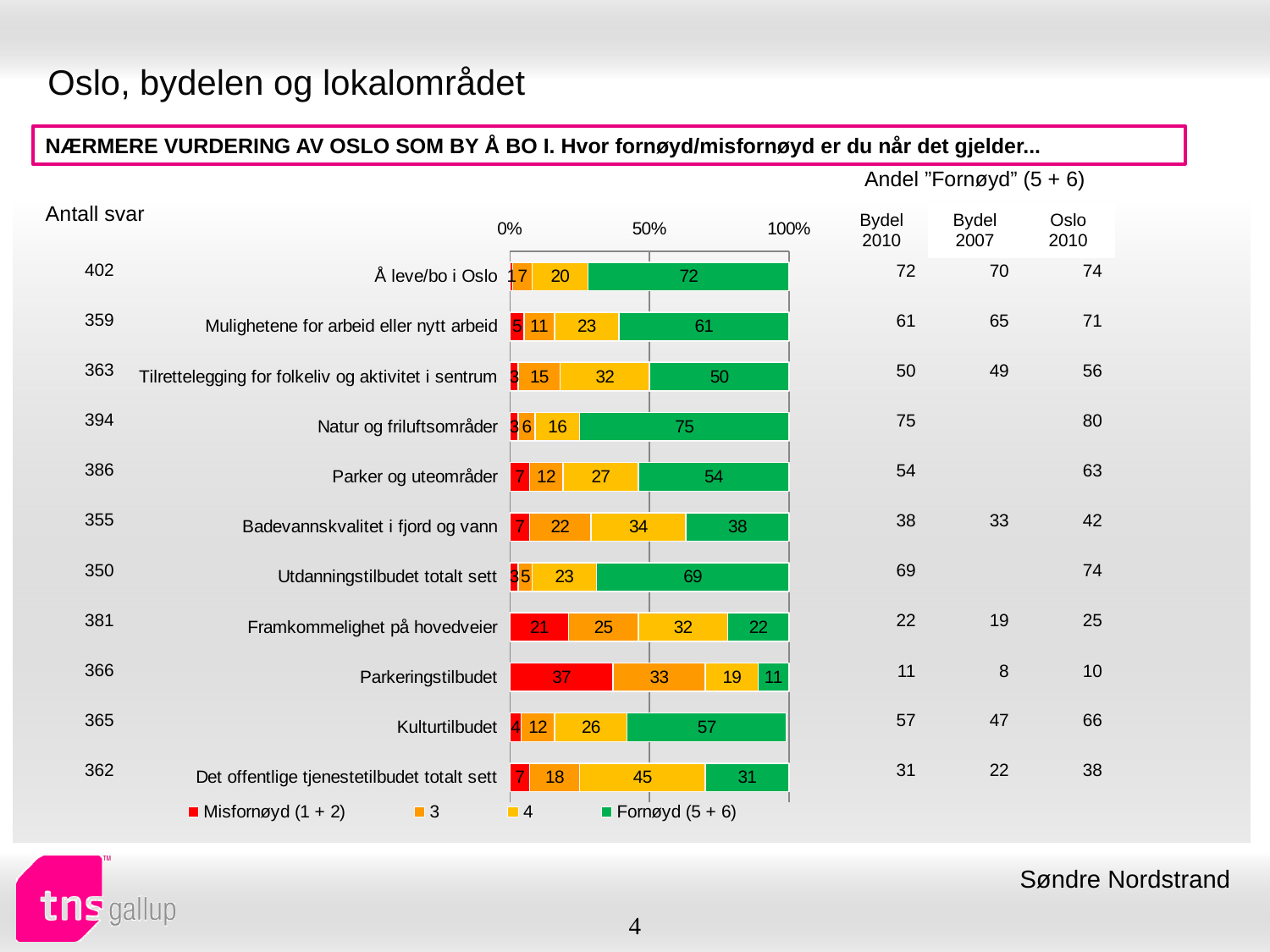
How many series does the chart legend list? 4 What is the Misfornøyd (1 + 2) value for Parkeringstilbudet? 37 What is the value of series 4 for Det offentlige tjenestetilbudet totalt sett? 45 What is the value of series 3 for Framkommelighet på hovedveier? 25 Which has a larger Fornøyd (5 + 6) value: Mulighetene for arbeid eller nytt arbeid or Parker og uteområder? Mulighetene for arbeid eller nytt arbeid What is the Fornøyd (5 + 6) value for Natur og friluftsområder? 75 Which category has the lowest Fornøyd (5 + 6) value? Parkeringstilbudet How many categories (rows) are plotted in the chart? 11 Which legend entry is shown in green? Fornøyd (5 + 6) What kind of chart is shown on the slide? Stacked bar chart What is the difference between the Fornøyd (5 + 6) values for Å leve/bo i Oslo and Badevannskvalitet i fjord og vann? 34 Which category has the highest Fornøyd (5 + 6) value? Natur og friluftsområder